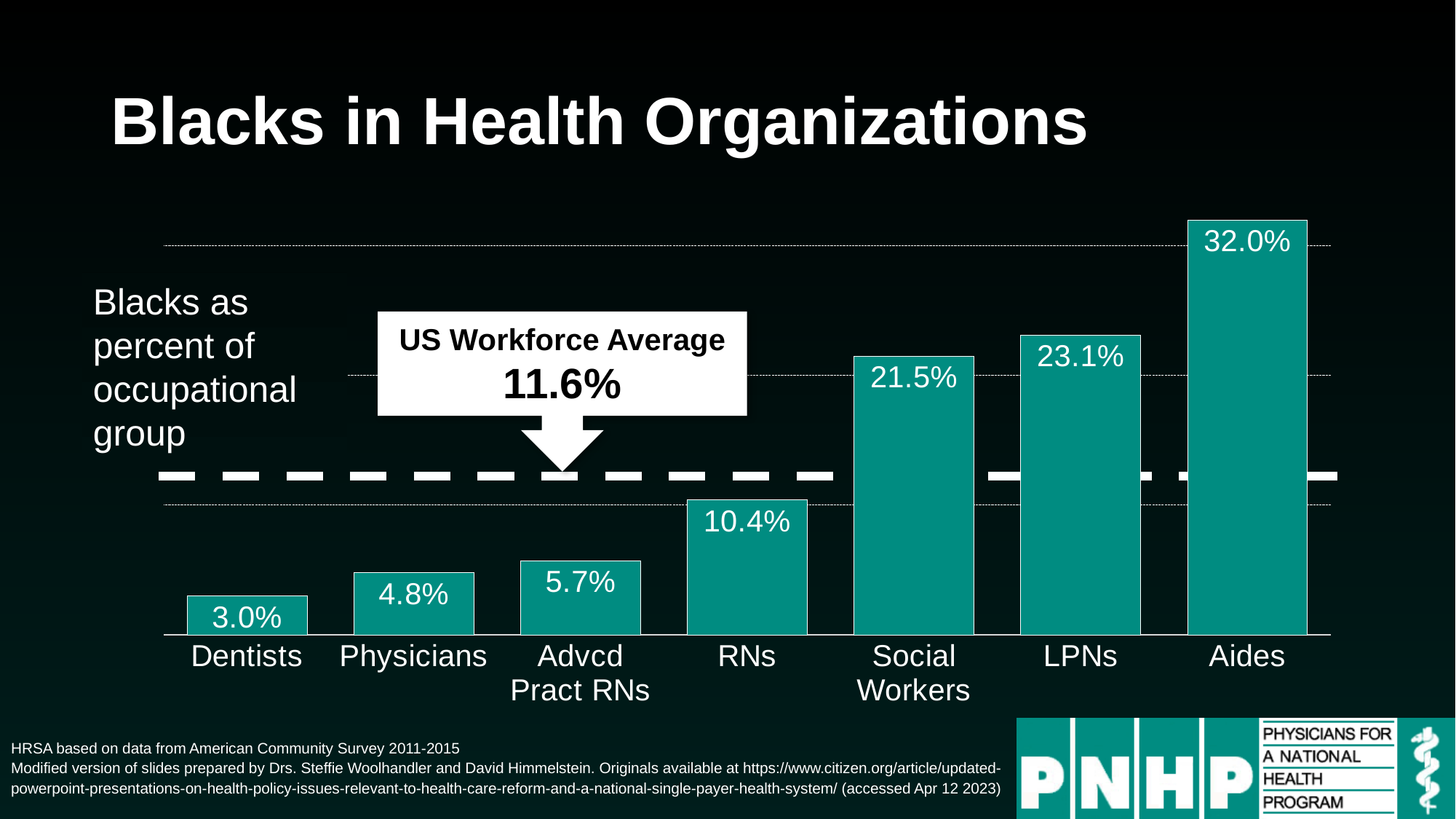
Which is larger, the value for RNs or the value for Physicians? RNs What kind of chart is shown on the slide? Bar chart Do the values rise or fall moving from left to right across the categories? Rise What US Workforce Average is marked on the chart? 11.6% What percentage of dentists are Black according to the chart? 3.0% Which occupational group has the highest percentage of Blacks? Aides What is the value shown for Advcd Pract RNs? 5.7% How many occupational groups are shown in the chart? 7 What is the difference between the values for Aides and LPNs? 8.9% What is the value shown for Social Workers? 21.5% What is the difference between the values for Physicians and Dentists? 1.8% Which occupational group has the lowest percentage of Blacks? Dentists